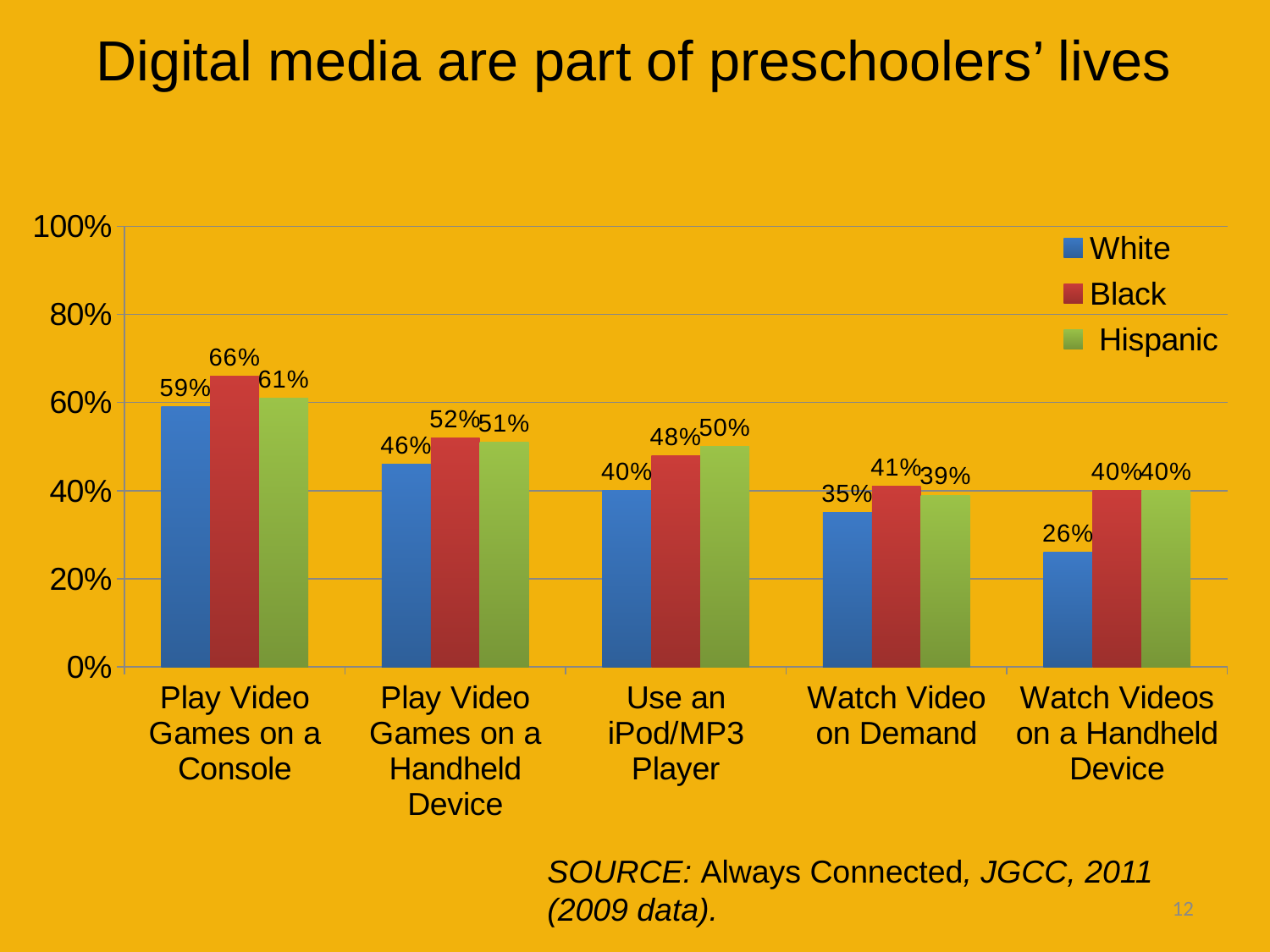
What is the value for Hispanic preschoolers who watch video on demand? 39% Which group has the highest value for playing video games on a console? Black What is the difference between the Black and White values for playing video games on a handheld device? 6% How many activity categories are shown on the x axis? 5 What is the value for Black preschoolers who use an iPod/MP3 player? 48% Is the White value for watching videos on a handheld device greater or less than 40%? less What percentage of White preschoolers play video games on a console? 59% How many series does the legend list? 3 Which group has the lowest value for watching videos on a handheld device? White What kind of chart is shown on the slide? bar chart What colour represents the Hispanic series in the chart? green Is the White value for watching video on demand larger or smaller than the Hispanic value for the same activity? smaller